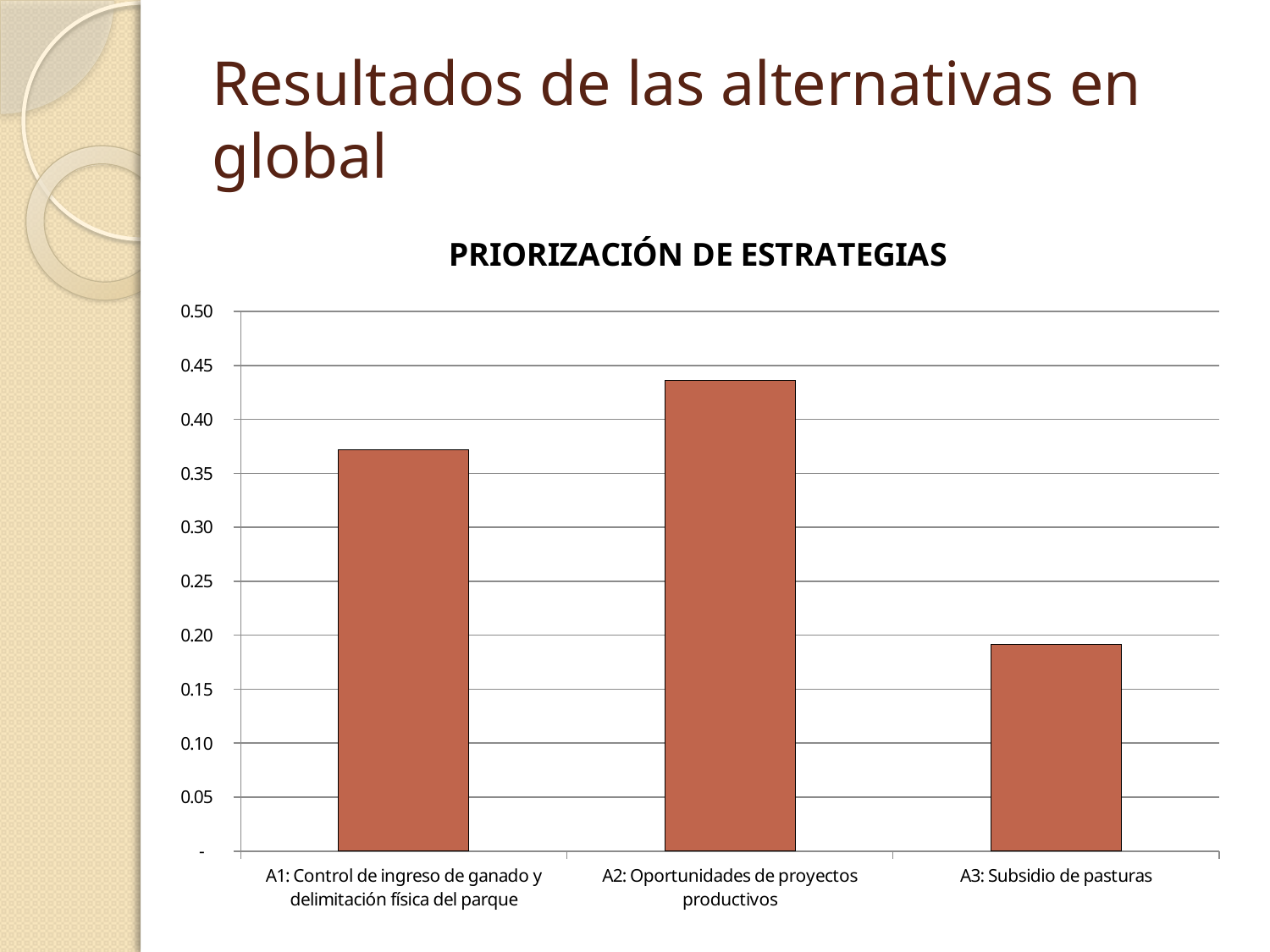
Is the value for A2: Oportunidades de proyectos productivos greater or less than 0.40? greater What is the title of the chart? PRIORIZACIÓN DE ESTRATEGIAS Is the value for A1: Control de ingreso de ganado y delimitación física del parque greater or less than 0.35? greater Which alternative has the lowest value in the chart? A3: Subsidio de pasturas Which has a larger value, A1: Control de ingreso de ganado y delimitación física del parque or A3: Subsidio de pasturas? A1: Control de ingreso de ganado y delimitación física del parque What type of chart is shown on the slide? bar chart Is the value for A2: Oportunidades de proyectos productivos greater or less than 0.45? less How many categories (alternatives) are plotted in the chart? 3 What is the maximum value shown on the vertical axis of the chart? 0.50 Which has a larger value, A2: Oportunidades de proyectos productivos or A1: Control de ingreso de ganado y delimitación física del parque? A2: Oportunidades de proyectos productivos Which alternative has the highest value in the chart? A2: Oportunidades de proyectos productivos